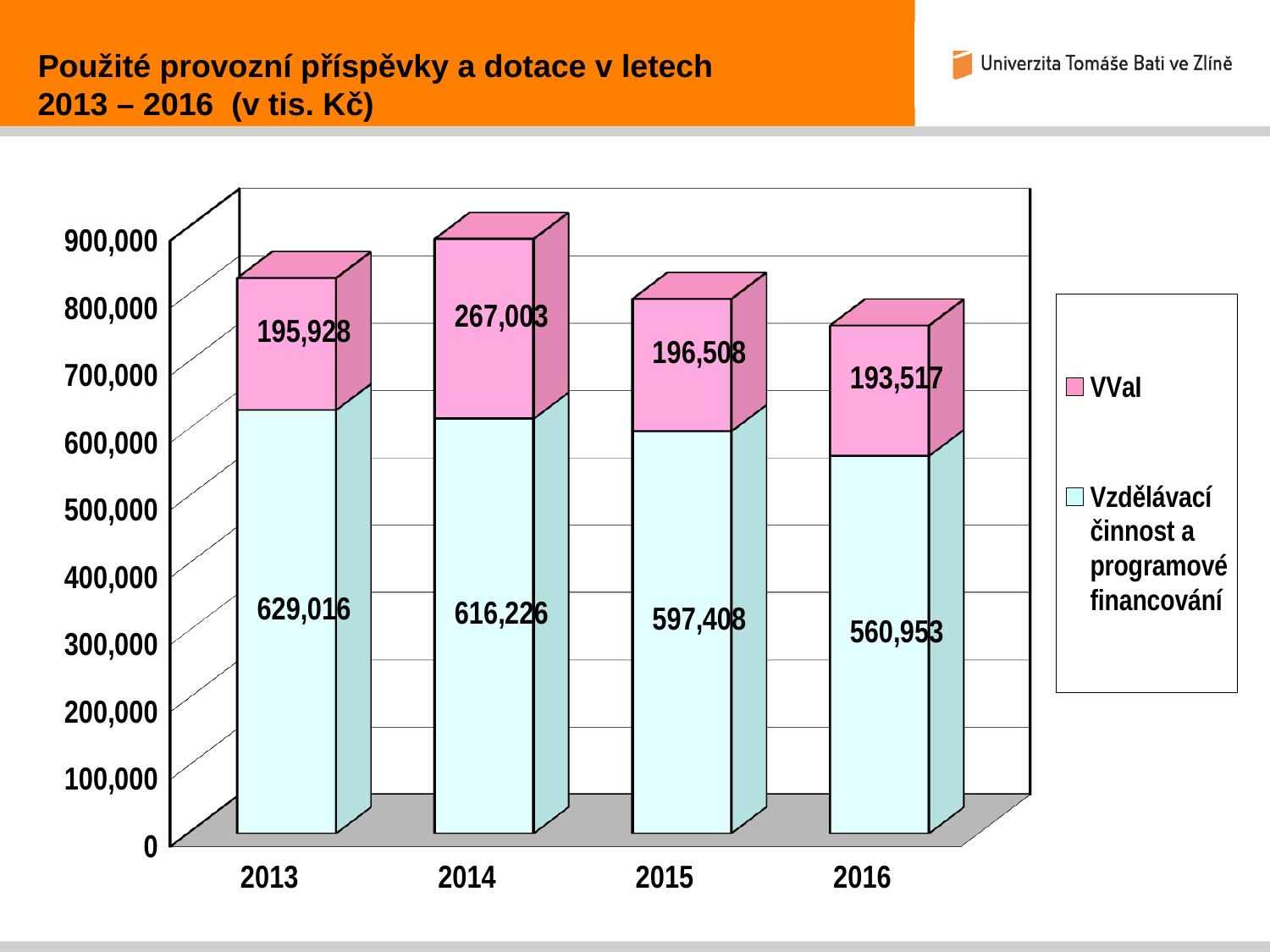
What is the value for Vzdělávací činnost a programové financování in 2016? 560,953 What is the total of the stacked bar for 2016? 754,470 What is the difference between the Vzdělávací činnost a programové financování values for 2013 and 2016? 68,063 How many years are shown on the x axis? 4 What is the value for VVaI in 2013? 195,928 How many series does the legend list? 2 Which year has the lowest value for VVaI? 2016 Which year has the highest value for Vzdělávací činnost a programové financování? 2013 What is the total of the stacked bar for 2014? 883,229 What is the value for VVaI in 2014? 267,003 What kind of chart is shown on the slide? Stacked bar chart Which is larger: the VVaI value in 2014 or in 2015? 2014